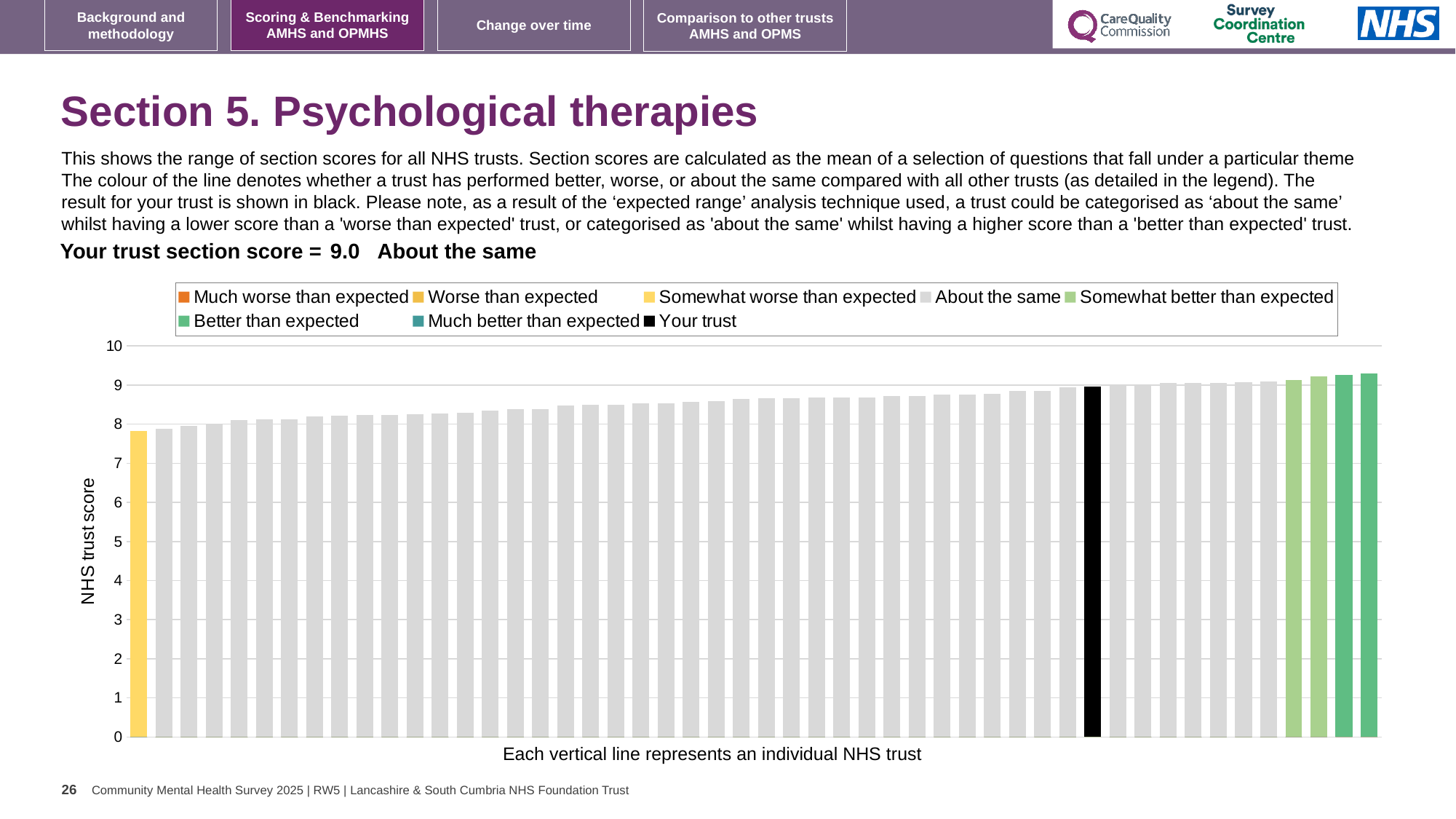
Is the value for your trust greater or less than 8? greater Which category is your trust placed in for this section? About the same How many bars are coloured as 'Somewhat worse than expected'? 1 What is the label on the vertical axis of the chart? NHS trust score Do the bar values rise or fall from left to right along the x axis? rise How many bars are coloured as 'Better than expected'? 2 What kind of chart is shown on the slide? bar chart Which is larger, the value for your trust or the value of the leftmost bar? your trust Is the value of the highest bar greater or less than 9? greater What is the section score for your trust? 9.0 How many entries does the chart legend list? 8 Is the value of the lowest bar greater or less than 7? greater